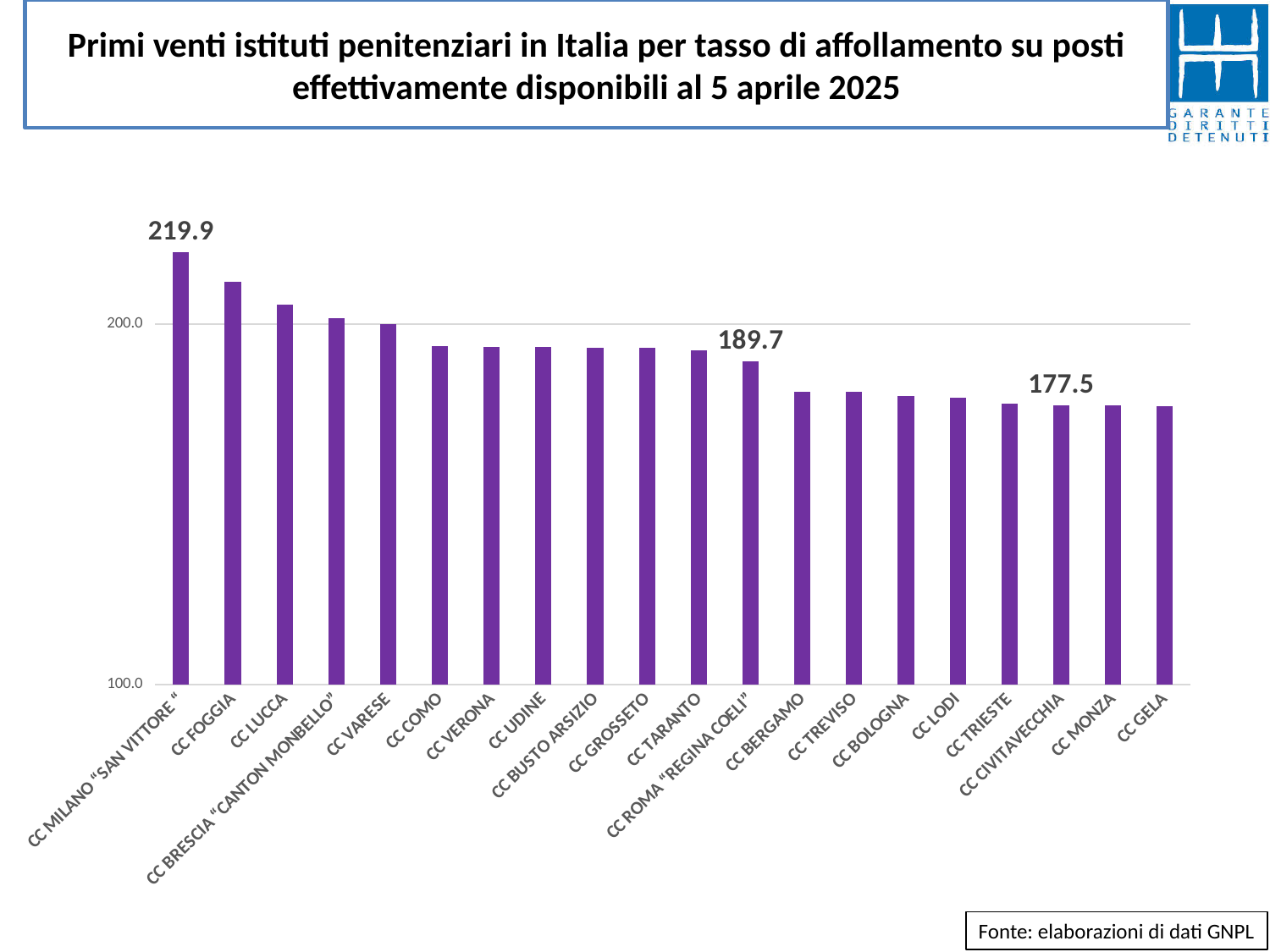
Which is larger, the value for CC ROMA "REGINA COELI" or the value for CC CIVITAVECCHIA? CC ROMA "REGINA COELI" Which institute has the highest value? CC MILANO "SAN VITTORE" Do the values rise or fall from left to right along the x axis? fall How many institutes are shown in the chart? 20 What is the value for CC ROMA "REGINA COELI"? 189.7 What is the difference between the values for CC MILANO "SAN VITTORE" and CC ROMA "REGINA COELI"? 30.2 Is the value for CC FOGGIA greater or less than 200.0? greater What is the value for CC MILANO "SAN VITTORE"? 219.9 What kind of chart is shown on the slide? bar chart What is the difference between the values for CC ROMA "REGINA COELI" and CC CIVITAVECCHIA? 12.2 Is the value for CC BERGAMO greater or less than 200.0? less What is the value for CC CIVITAVECCHIA? 177.5